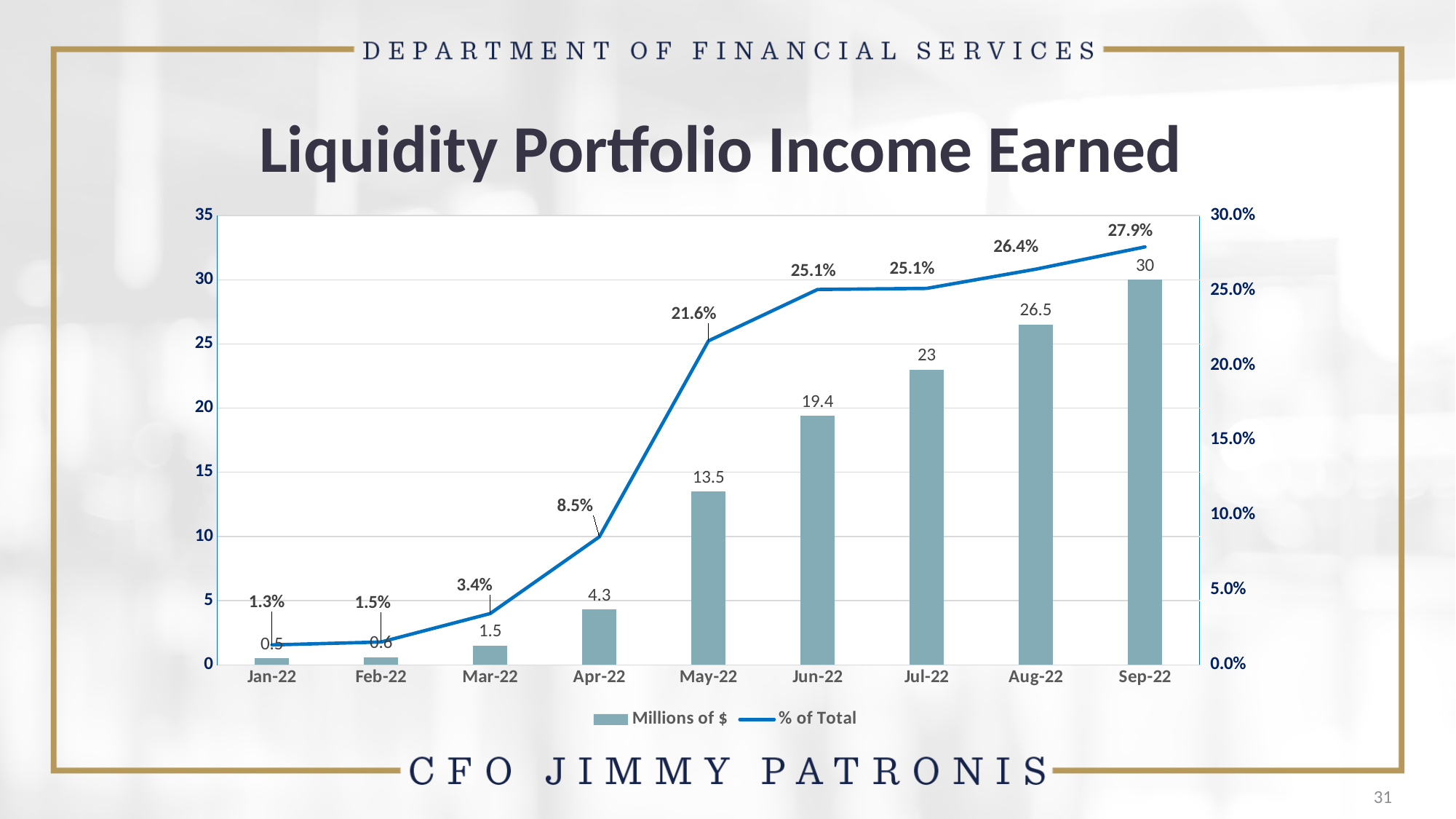
What kind of chart is this? Combined bar and line chart Which month has the lowest % of Total value? Jan-22 What is the Millions of $ value for Jun-22? 19.4 What is the difference in Millions of $ between Aug-22 and Jul-22? 3.5 What is the Millions of $ value for Sep-22? 30 Do the Millions of $ values rise or fall from Jan-22 to Sep-22? Rise How many months are shown on the x axis? 9 How many series does the legend list? 2 Which month has the highest Millions of $ value? Sep-22 What is the % of Total value for May-22? 21.6% What is the title of the chart? Liquidity Portfolio Income Earned Which is larger, the Millions of $ value for Apr-22 or for May-22? May-22